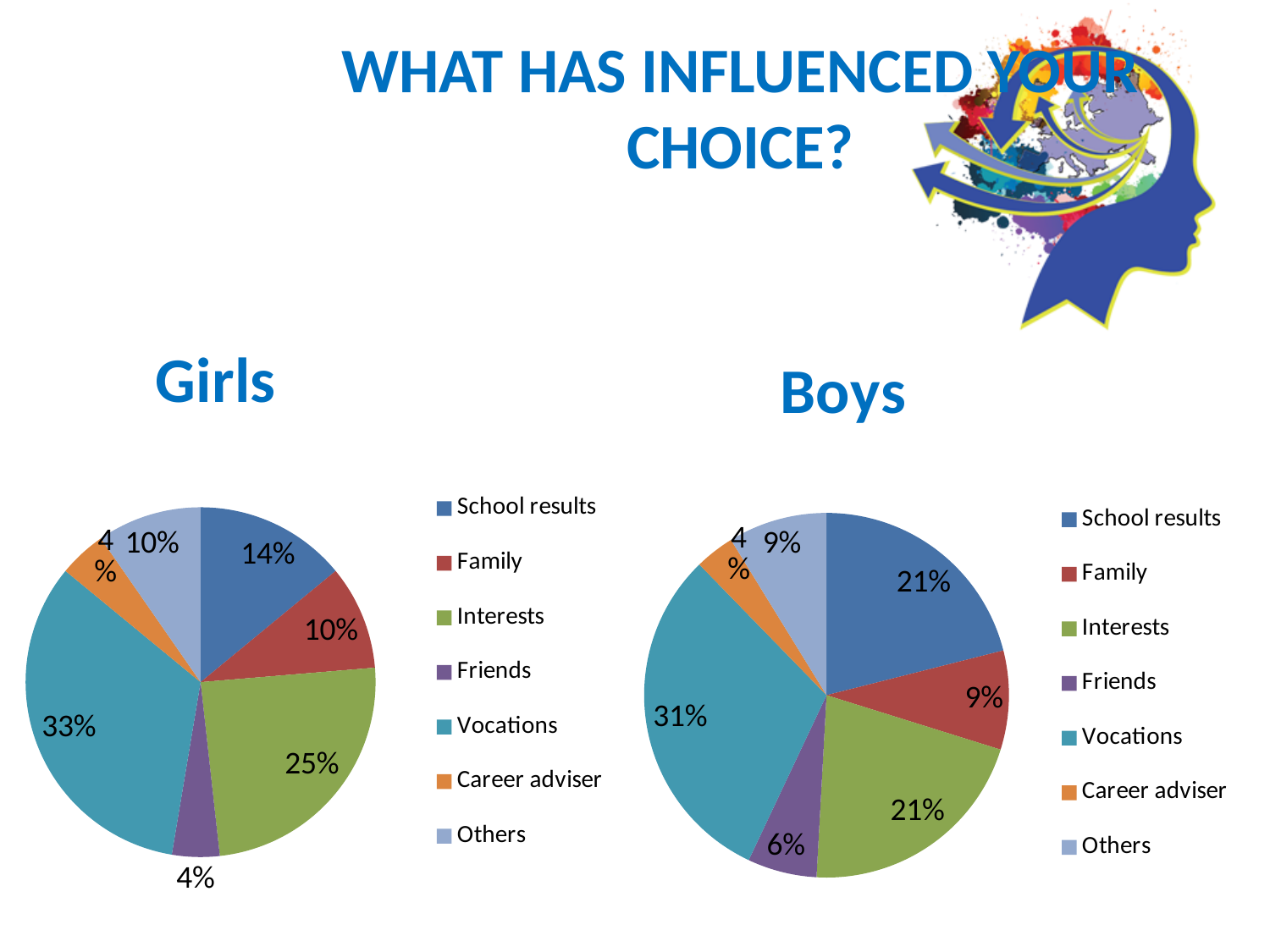
In the Girls pie chart, what is the difference between the Vocations share and the School results share? 19% In the Girls pie chart, what share is Interests? 25% In the Girls pie chart, what share is Vocations? 33% In the Boys pie chart, what share is School results? 21% In the Boys pie chart, what is the difference between the Vocations share and the Interests share? 10% In the Boys pie chart, which category has the smallest share? Career adviser How many categories does the Boys pie chart show? 7 What colour represents Vocations in the Boys pie chart? Teal In the Girls pie chart, which category has the largest share? Vocations What type of chart is used for the Girls data? Pie chart In the Boys pie chart, what share is Friends? 6% In the Girls pie chart, which is larger, School results or Family? School results